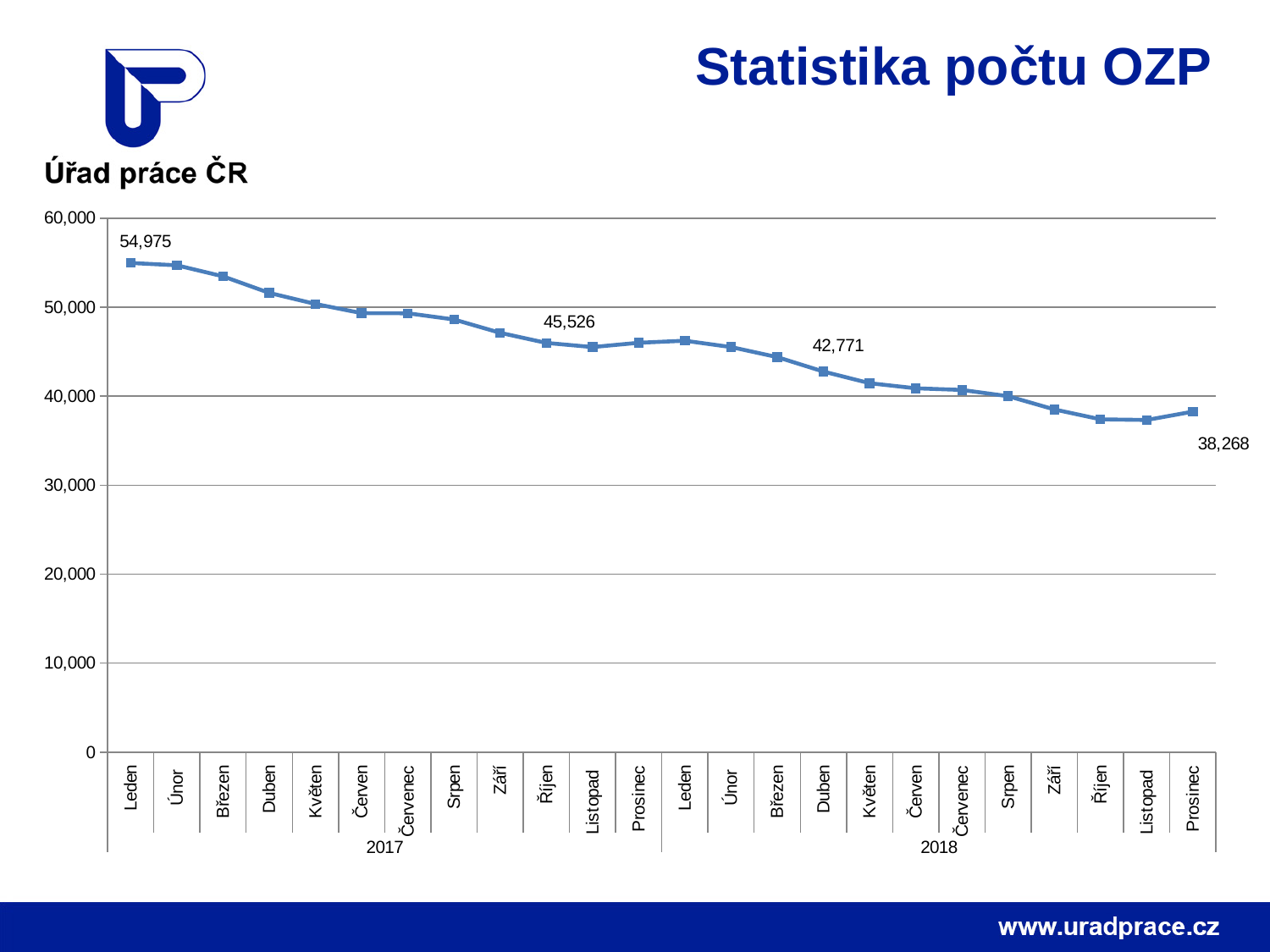
What is the value for Leden 2017? 54,975 How many data points are plotted on the chart? 24 What is the value for Prosinec 2018? 38,268 What is the value for Duben 2018? 42,771 What kind of chart is shown on the slide? line chart Is the value for Květen 2017 greater or less than 40,000? greater Is the value for Listopad 2018 greater or less than 40,000? less Do the values generally rise or fall from Leden 2017 to Prosinec 2018? fall What is the difference between the values for Leden 2017 and Prosinec 2018? 16,707 Which is larger, the value for Leden 2017 or the value for Leden 2018? Leden 2017